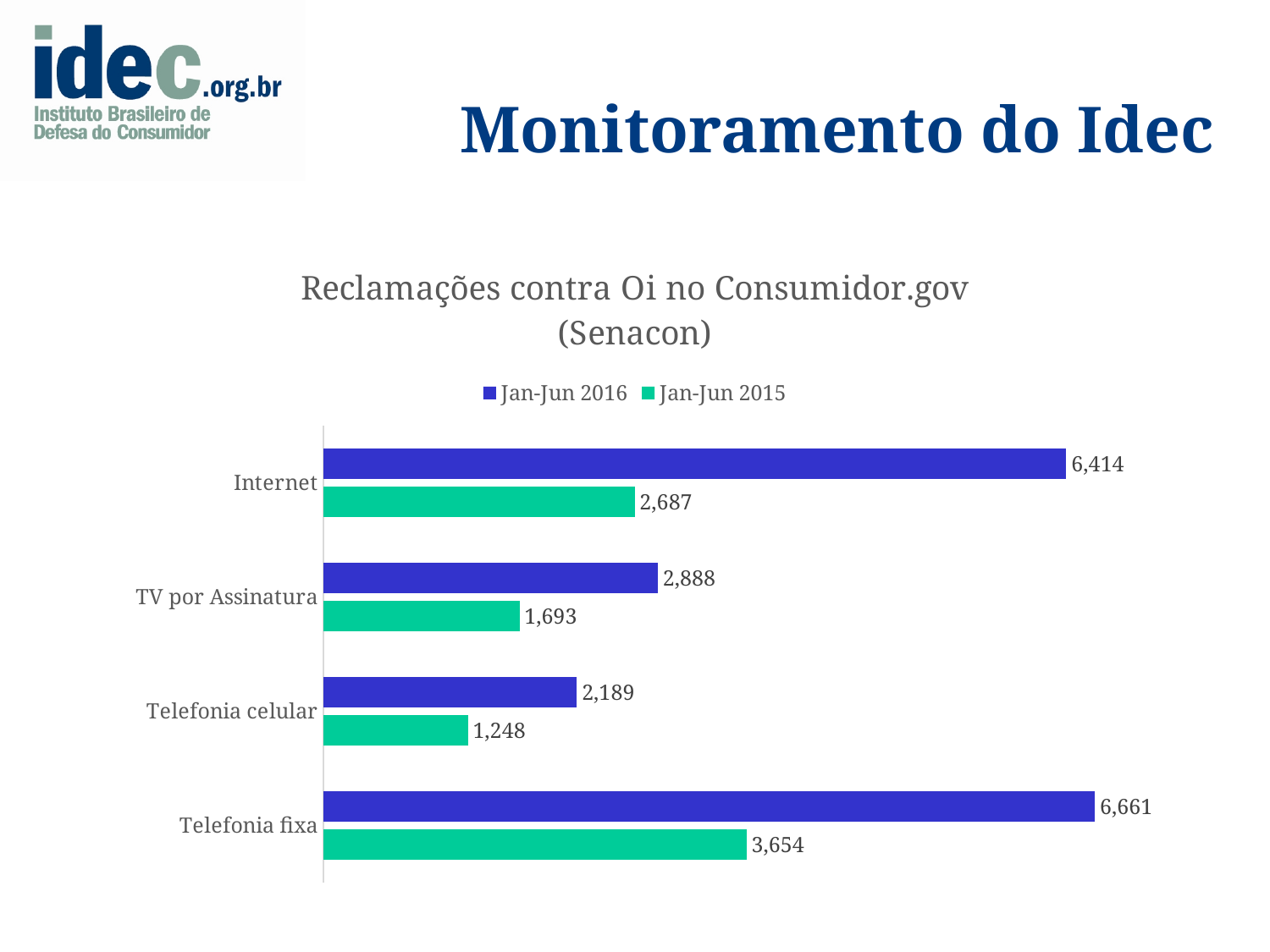
What is the difference between the Jan-Jun 2016 and Jan-Jun 2015 values for Internet? 3,727 What is the Jan-Jun 2016 value for Internet? 6,414 How many series does the legend list? 2 Which category has the highest Jan-Jun 2016 value? Telefonia fixa Which category has the lowest Jan-Jun 2015 value? Telefonia celular What is the difference between the Jan-Jun 2016 values for Telefonia fixa and Telefonia celular? 4,472 What is the title of the chart? Reclamações contra Oi no Consumidor.gov (Senacon) How many categories are shown on the chart? 4 What is the Jan-Jun 2015 value for TV por Assinatura? 1,693 Which is larger: the Jan-Jun 2016 value for TV por Assinatura or the Jan-Jun 2015 value for Telefonia fixa? Jan-Jun 2015 value for Telefonia fixa What is the Jan-Jun 2015 value for Telefonia fixa? 3,654 What kind of chart is shown on the slide? Bar chart